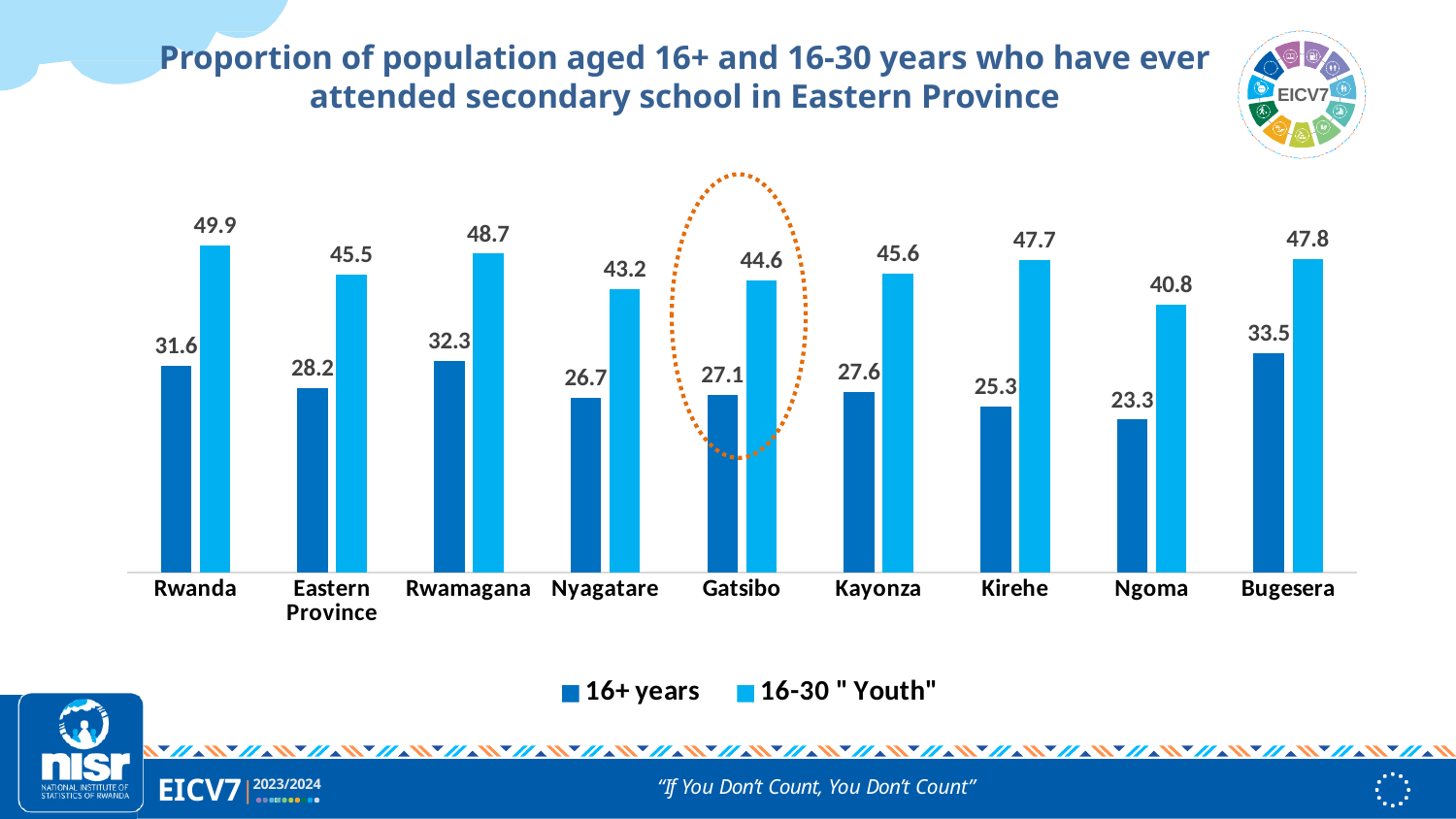
What kind of chart is shown on the slide? Bar chart In the 16+ years series, which is larger: Rwamagana or Nyagatare? Rwamagana Which category has the lowest value in the 16+ years series? Ngoma What is the difference between the 16-30 "Youth" value and the 16+ years value for Rwanda? 18.3 What is the value for Ngoma in the 16+ years series? 23.3 What is the value for Rwanda in the 16-30 "Youth" series? 49.9 Which category has the lowest value in the 16-30 "Youth" series? Ngoma How many categories are shown on the x axis? 9 What is the value for Gatsibo in the 16-30 "Youth" series? 44.6 What is the difference between the 16-30 "Youth" value and the 16+ years value for Gatsibo? 17.5 Which category has the highest value in the 16+ years series? Bugesera How many series does the legend list? 2